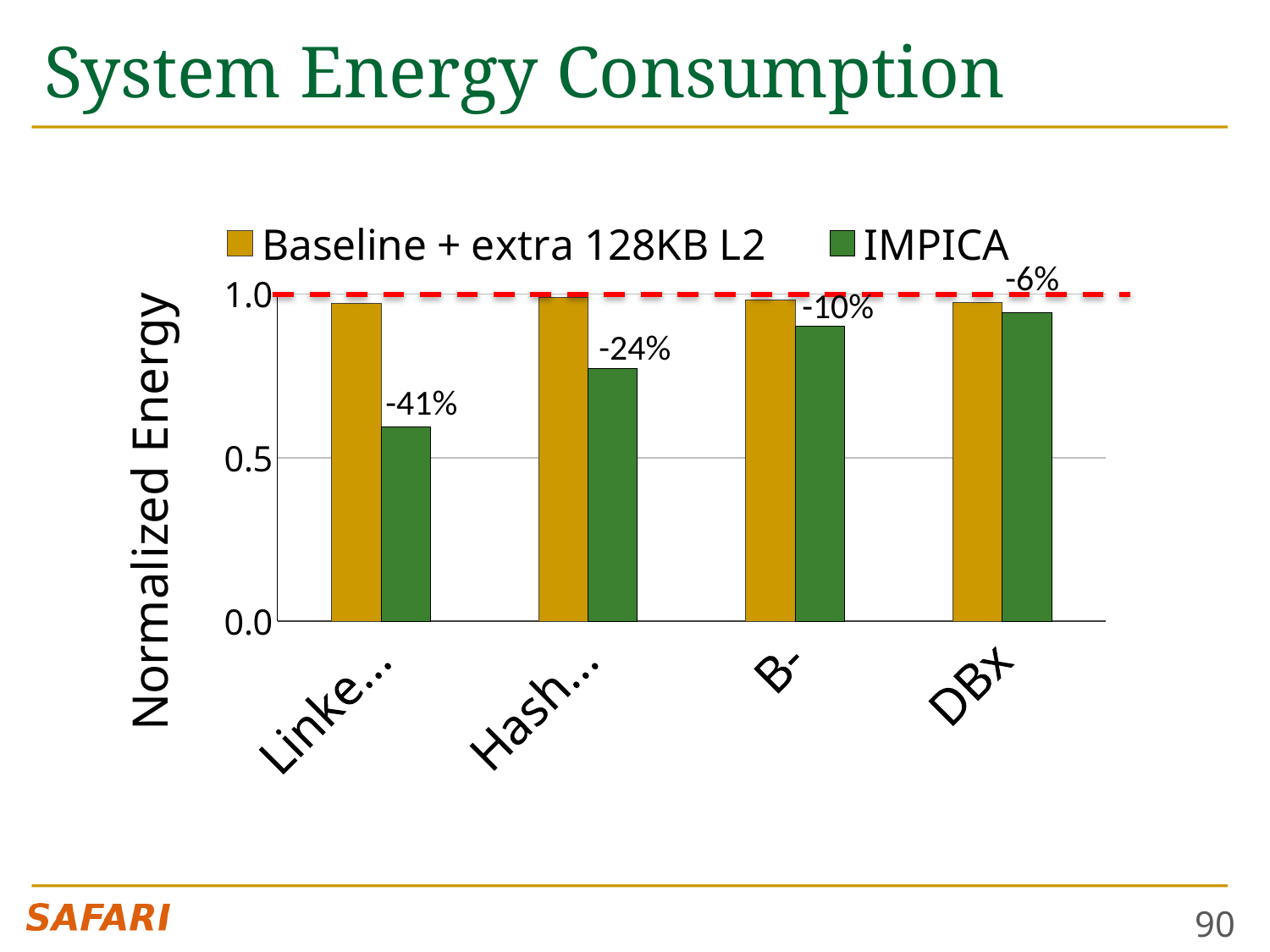
What colour are the IMPICA bars? green How many categories are shown along the x axis? 4 For B-, which is larger: the Baseline + extra 128KB L2 bar or the IMPICA bar? Baseline + extra 128KB L2 What percentage label is printed above the IMPICA bar for B-? -10% Which category has the lowest IMPICA bar? Linke... (the first category) What percentage label is printed above the IMPICA bar for DBx? -6% What percentage label is printed above the IMPICA bar for the second category (labelled 'Hash...')? -24% Is the IMPICA value for the first category (labelled 'Linke...') greater or less than 0.5? greater What is the title of the y axis? Normalized Energy What percentage label is printed above the IMPICA bar for the first category (labelled 'Linke...')? -41% How many series does the legend list? 2 What kind of chart is shown on the slide? bar chart